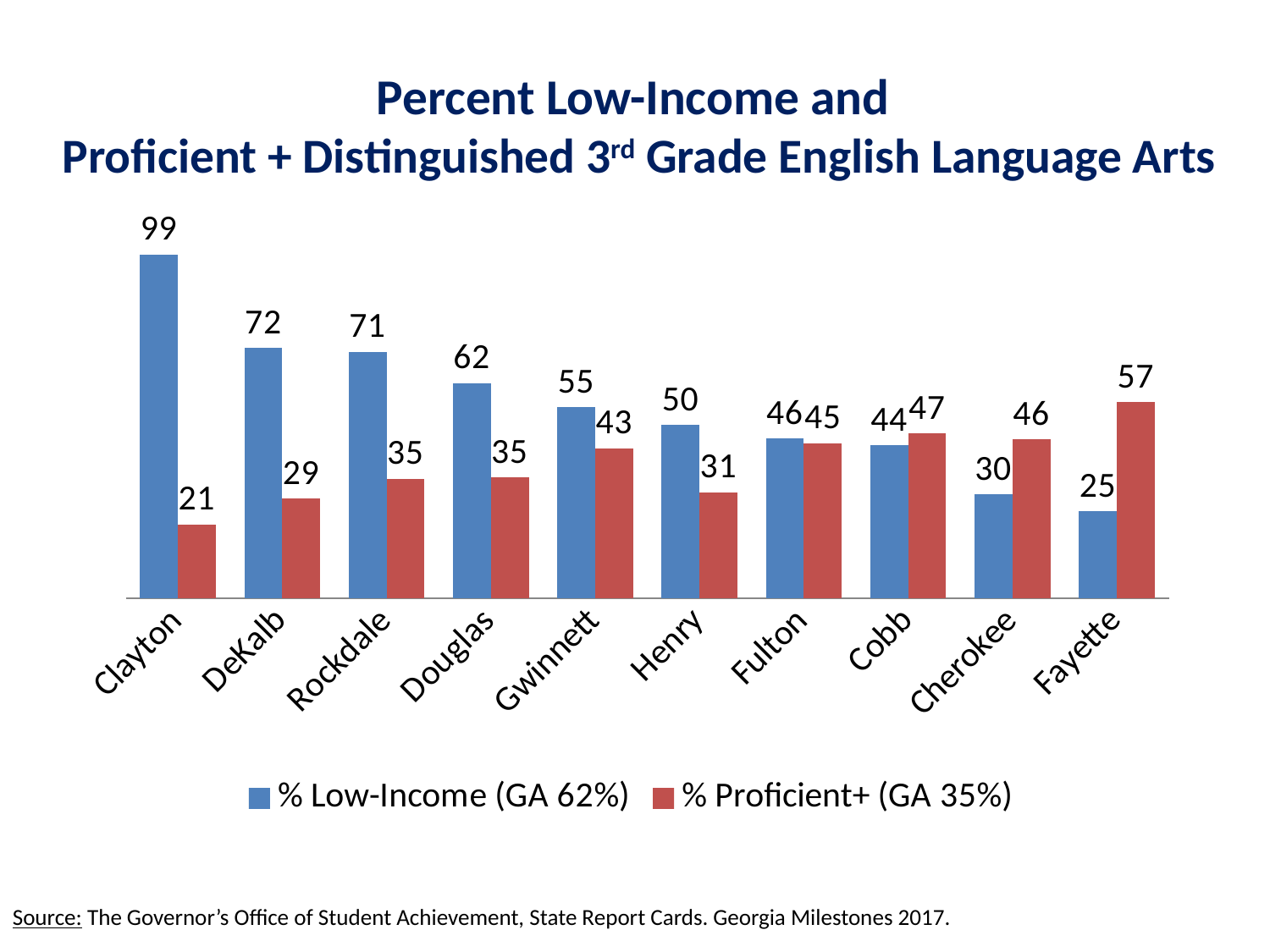
How many counties are shown on the x axis? 10 Which county has the highest % Low-Income value? Clayton What Georgia statewide value is given in the legend for % Proficient+? 35% What is the % Proficient+ value for Gwinnett? 43 Do the % Low-Income values rise or fall from Clayton to Fayette along the x axis? Fall What is the % Low-Income value for Clayton? 99 What kind of chart is shown on the slide? Bar chart Which county has the lowest % Proficient+ value? Clayton What is the % Proficient+ value for Fayette? 57 What is the difference between the % Low-Income and % Proficient+ values for Clayton? 78 How many series does the legend list? 2 Which is larger for Cobb, the % Low-Income value or the % Proficient+ value? % Proficient+